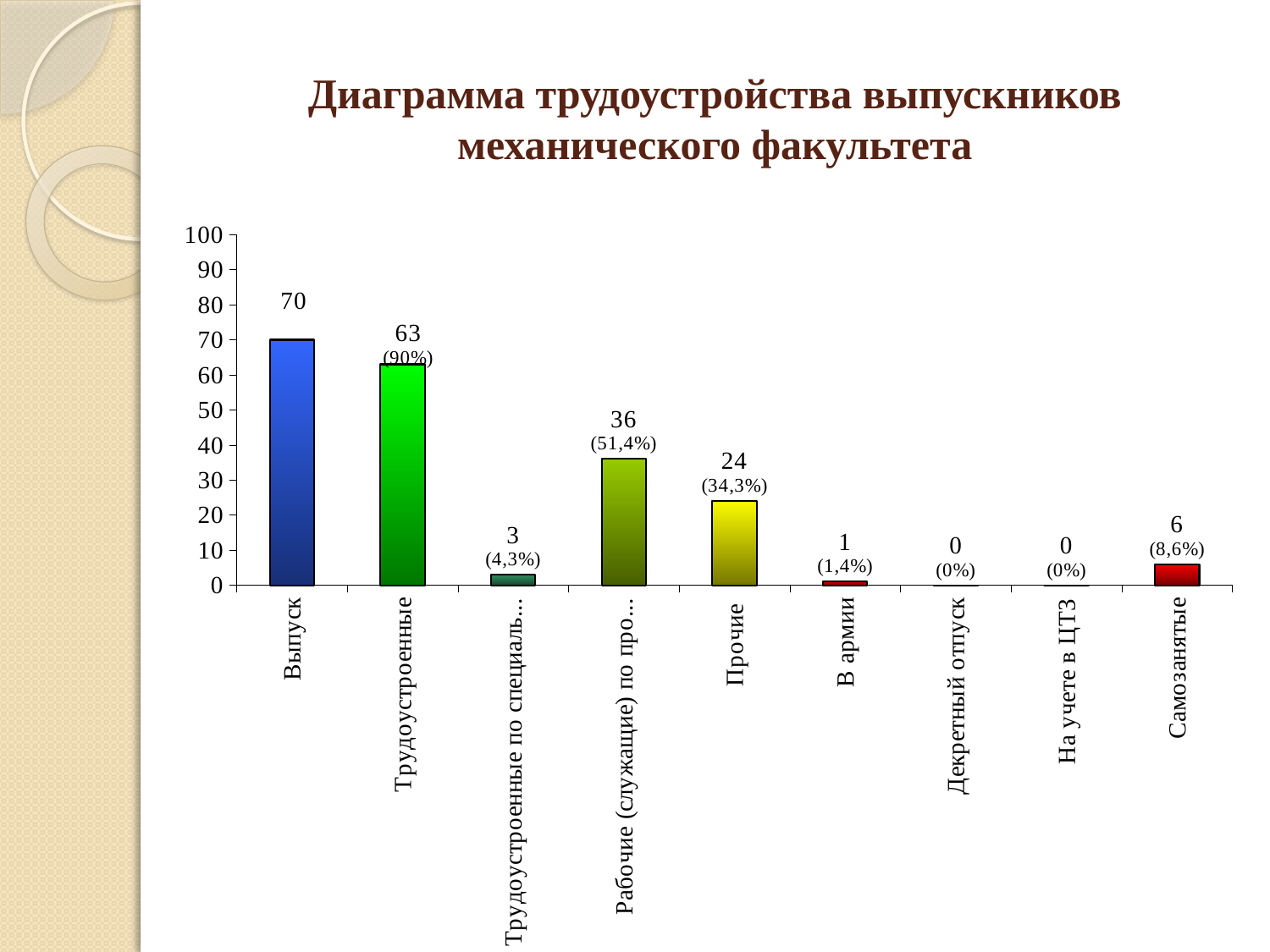
What is the title of the chart? Диаграмма трудоустройства выпускников механического факультета Which category has the highest value? Выпуск What percentage is shown for В армии? 1,4% What is the value for Выпуск? 70 What is the value for Трудоустроенные? 63 What kind of chart is shown on the slide? Bar chart What percentage is shown for Прочие? 34,3% Which is larger, the value for Прочие or the value for Самозанятые? Прочие What is the difference between the values for Прочие and Самозанятые? 18 How many categories are shown on the x axis? 9 What is the value for Самозанятые? 6 What is the difference between the values for Выпуск and Трудоустроенные? 7